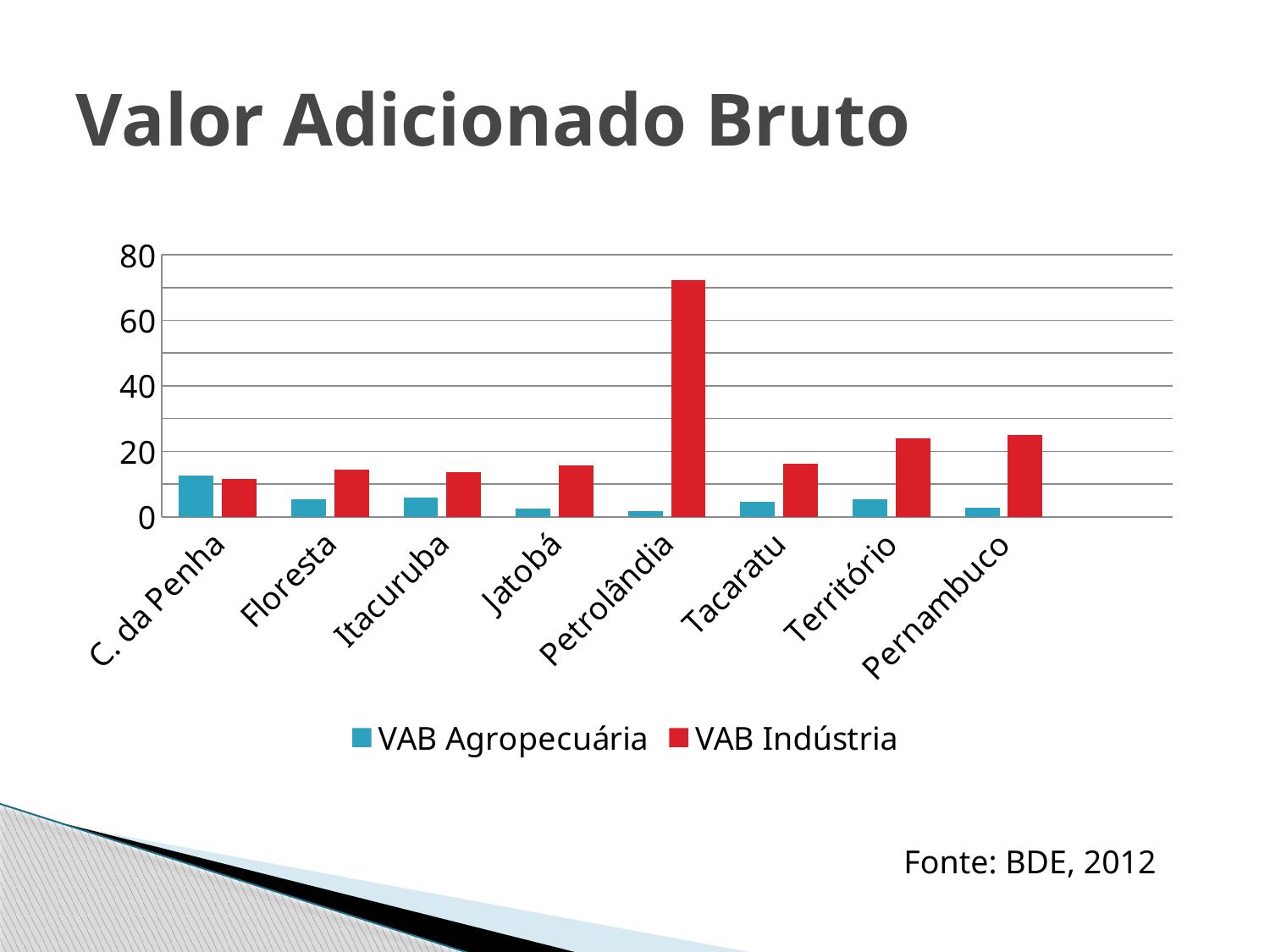
Which category has the highest VAB Indústria value? Petrolândia Which category has the highest VAB Agropecuária value? C. da Penha What is the title of the slide containing the chart? Valor Adicionado Bruto Is the VAB Indústria value for Floresta greater or less than 20? less Is the VAB Agropecuária value for C. da Penha greater or less than 20? less For Petrolândia, which is larger: VAB Agropecuária or VAB Indústria? VAB Indústria How many categories are shown on the x axis? 8 How many series does the legend list? 2 Is the VAB Indústria value for Território greater or less than 20? greater What kind of chart is shown on the slide? bar chart Which series is shown in red? VAB Indústria